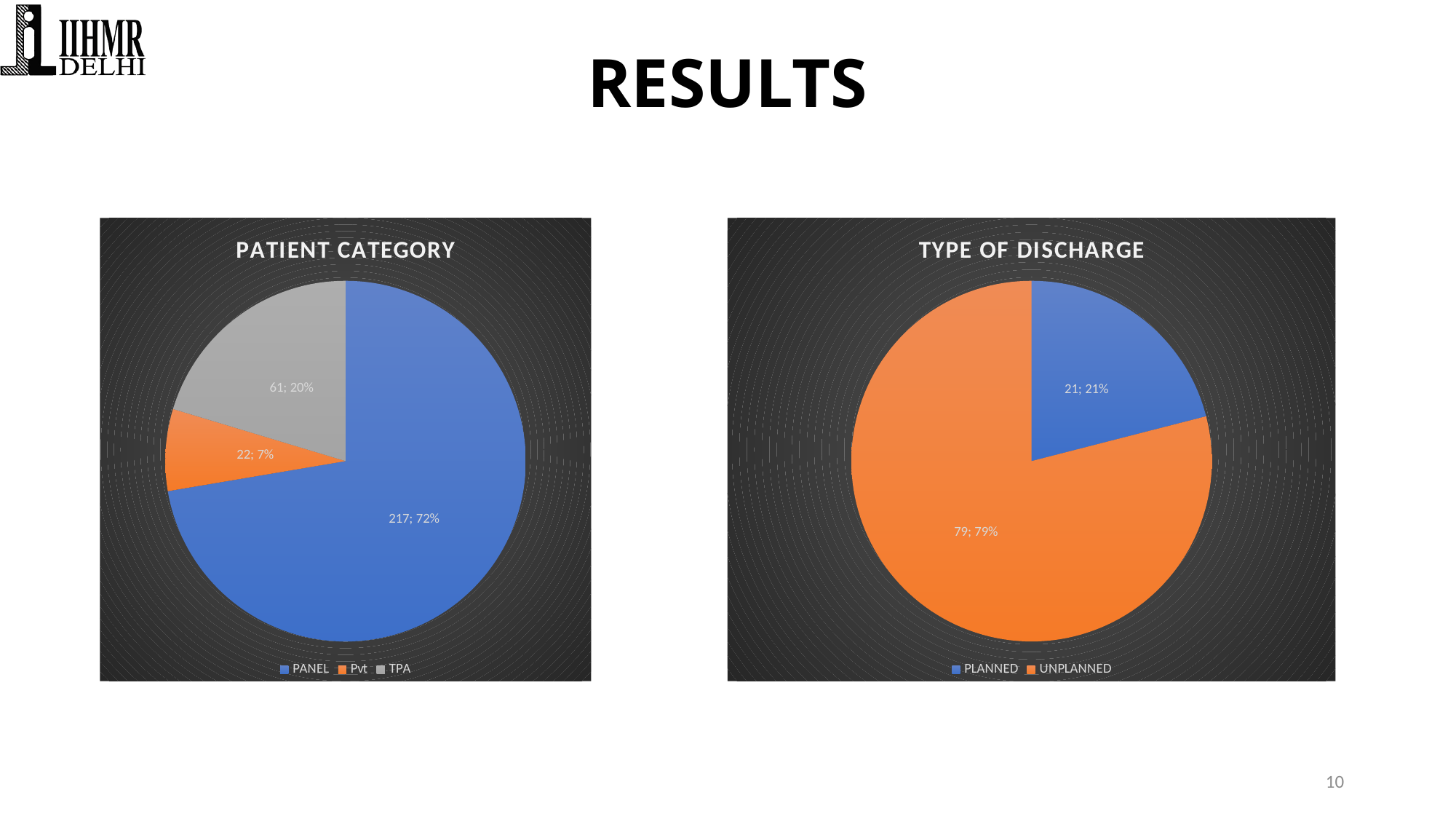
In the TYPE OF DISCHARGE chart, what share of the pie does PLANNED represent? 21% What kind of chart is the TYPE OF DISCHARGE chart? Pie chart In the PATIENT CATEGORY chart, what share of the pie does Pvt represent? 7% In the PATIENT CATEGORY chart, which category is the largest? PANEL In the PATIENT CATEGORY chart, which category is the smallest? Pvt In the PATIENT CATEGORY chart, what is the difference between the PANEL and TPA values? 156 In the PATIENT CATEGORY chart, what is the value for TPA? 61 How many categories does the PATIENT CATEGORY chart show? 3 In the PATIENT CATEGORY chart, what is the value for PANEL? 217 In the TYPE OF DISCHARGE chart, what is the value for UNPLANNED? 79 In the TYPE OF DISCHARGE chart, which is larger, PLANNED or UNPLANNED? UNPLANNED In the TYPE OF DISCHARGE chart, what colour is the UNPLANNED slice? Orange